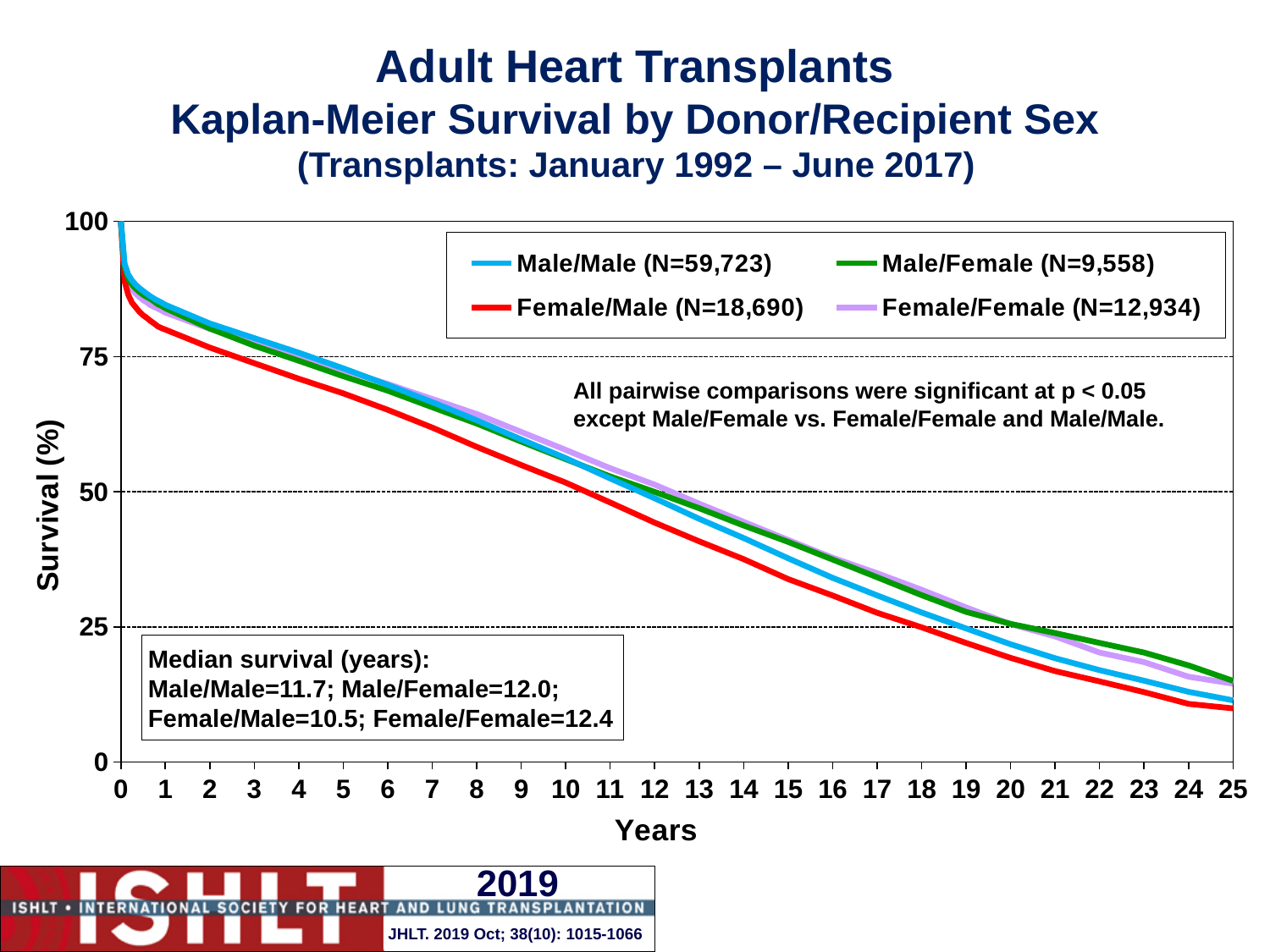
What is the N for the Male/Male group shown in the legend? 59,723 Do the survival curves rise or fall as years increase? fall Which donor/recipient group has the highest median survival? Female/Female What is the median survival in years for the Female/Female group? 12.4 How many series does the legend list? 4 What is the difference in median survival (years) between Female/Female and Female/Male? 1.9 Which legend entry has N=9,558? Male/Female Is the survival value for Female/Male at 15 years greater or less than 50? less Which has the larger median survival, Male/Female or Male/Male? Male/Female Which donor/recipient group has the lowest median survival? Female/Male What kind of chart is shown on the slide? line chart Is the survival value for Male/Male at 2 years greater or less than 75? greater